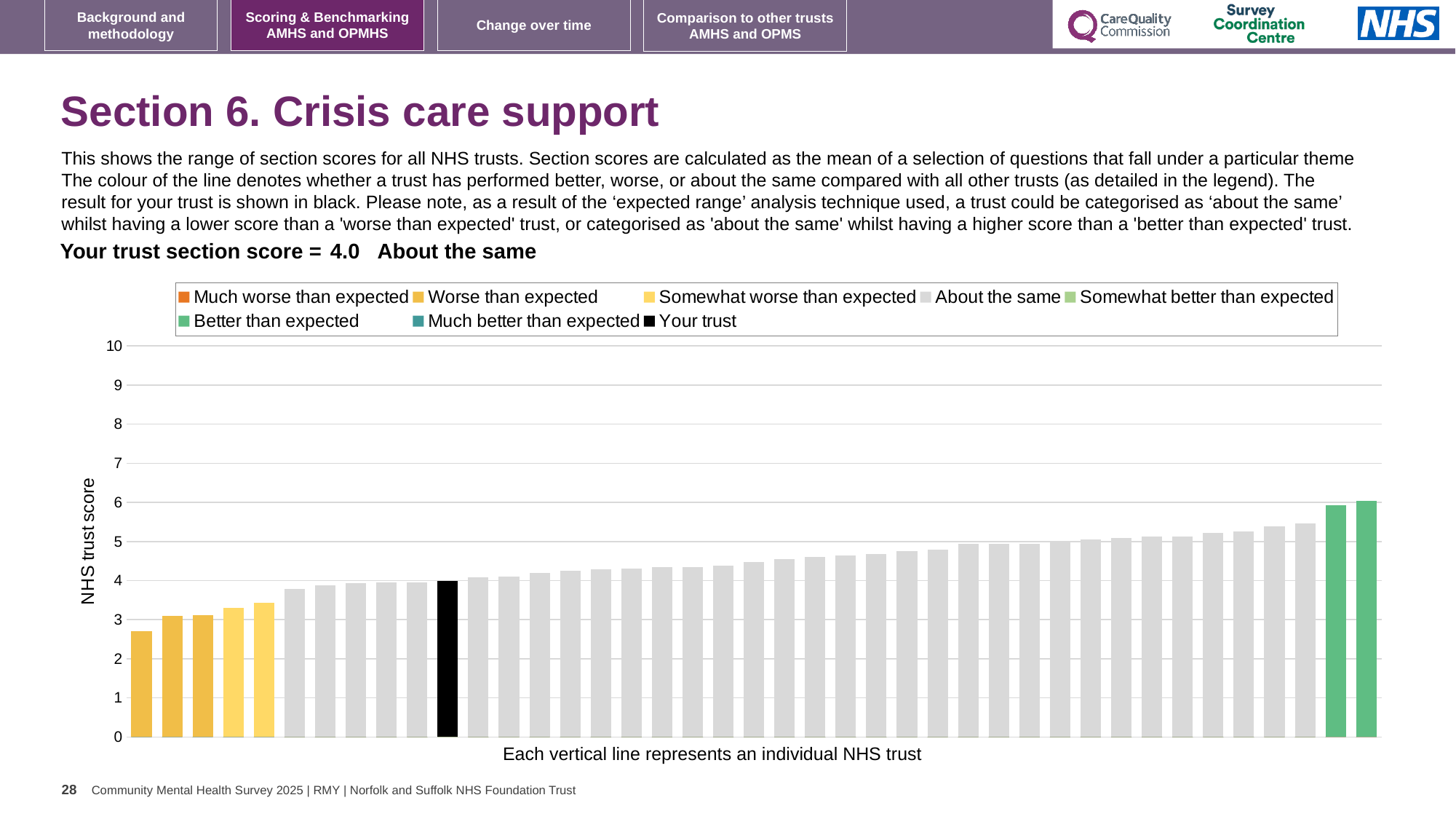
How many entries does the chart legend list? 8 How many bars are coloured as 'Better than expected'? 2 Which is higher, the leftmost bar or the rightmost bar? the rightmost bar Is the value of the shortest bar greater or less than 3? less Which category is your trust placed in for this section? About the same How many bars are coloured as 'Worse than expected'? 3 Do the bar values rise or fall from left to right along the x axis? rise What is the label on the vertical axis of the chart? NHS trust score What kind of chart is shown on the slide? bar chart Is the value of the tallest bar greater or less than 5? greater Is your trust's score (the black bar) greater or less than 5? less What is the section score for your trust shown on the slide? 4.0